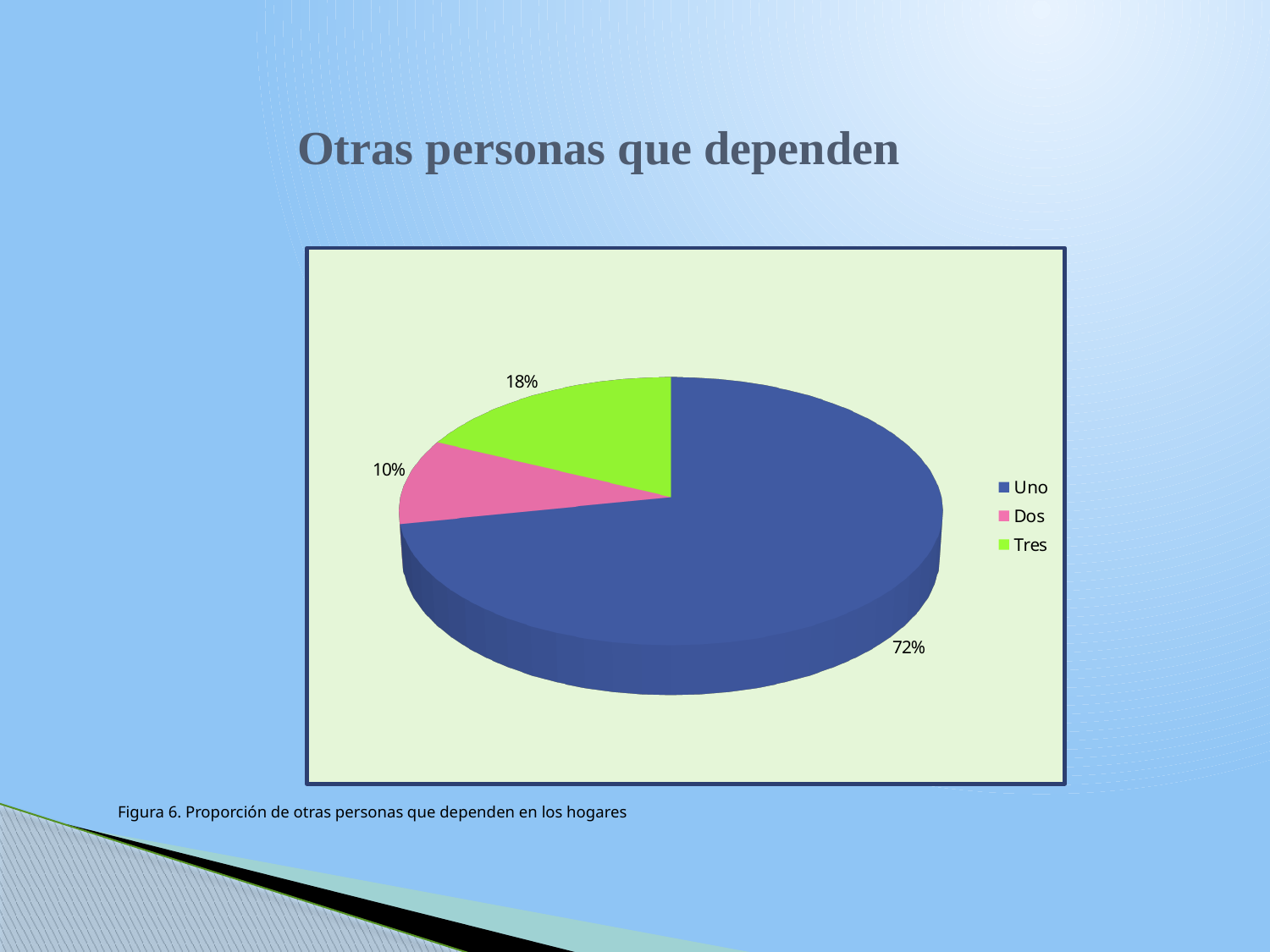
What is the difference between the values for Uno and Tres? 54% What is the value for Tres? 18% Which category has the smallest share of the pie? Dos Which is larger, the value for Dos or the value for Tres? Tres What is the value for Dos? 10% What is the value for Uno? 72% What colour is the slice for Tres? green What is the difference between the values for Tres and Dos? 8% What is the title of the chart? Otras personas que dependen What kind of chart is shown on the slide? pie chart How many categories does the pie chart have? 3 Which category has the largest share of the pie? Uno